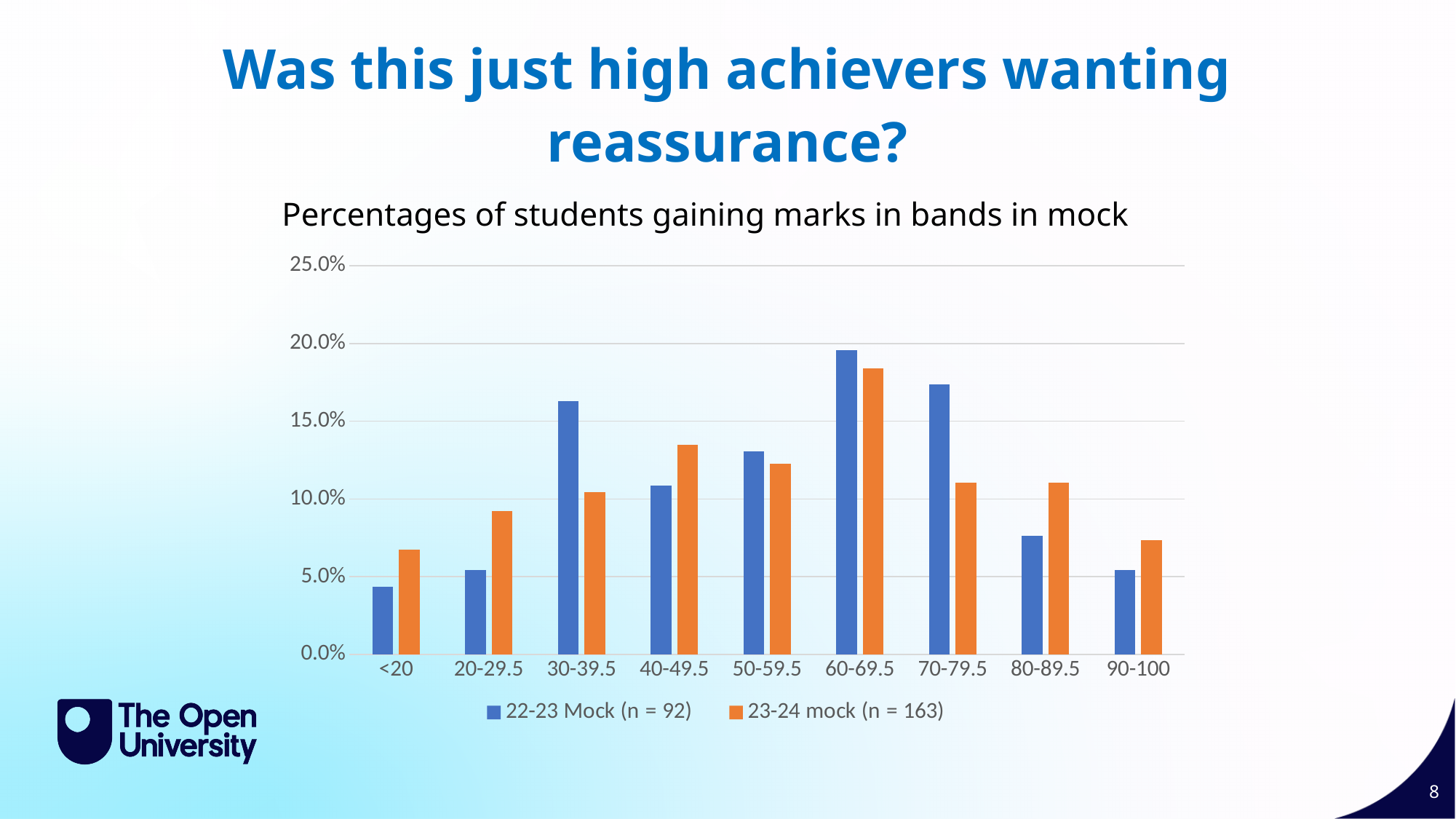
Which mark band has the highest value for the 22-23 Mock (n = 92) series? 60-69.5 In the 30-39.5 band, which series has the larger value, 22-23 Mock or 23-24 mock? 22-23 Mock (n = 92) How many series does the legend list? 2 Is the value for the 22-23 Mock series in the 60-69.5 band greater or less than 15.0%? greater How many mark bands are shown on the x axis? 9 Which mark band has the lowest value for the 23-24 mock (n = 163) series? <20 In the 80-89.5 band, which series has the larger value, 22-23 Mock or 23-24 mock? 23-24 mock (n = 163) What is the title of the chart? Percentages of students gaining marks in bands in mock Is the value for the 23-24 mock series in the 20-29.5 band greater or less than 10.0%? less Which mark band has the highest value for the 23-24 mock (n = 163) series? 60-69.5 What type of chart is shown on the slide? Bar chart Which mark band has the lowest value for the 22-23 Mock (n = 92) series? <20